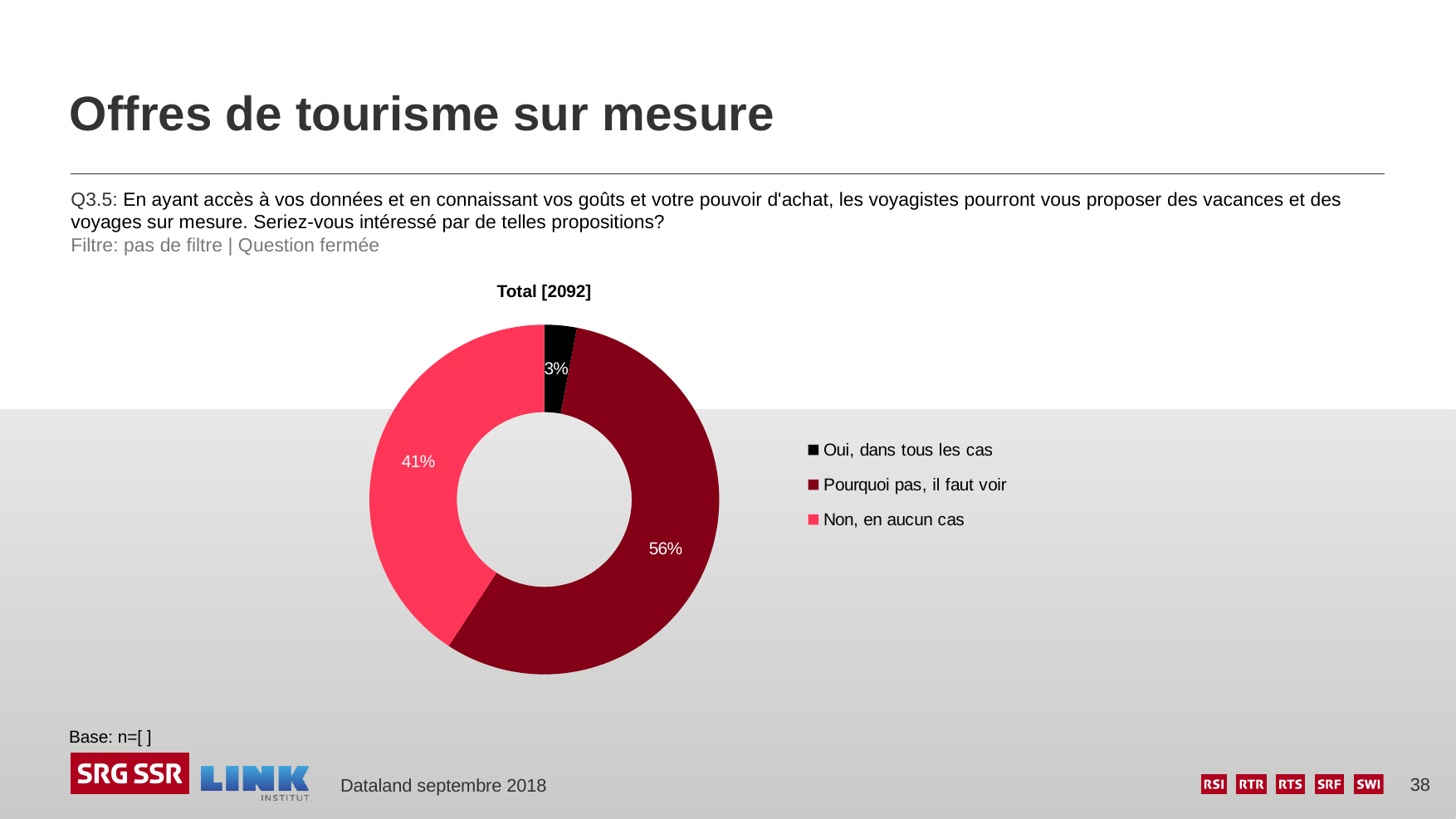
What share of respondents answered "Pourquoi pas, il faut voir"? 56% Which is larger: the share for "Non, en aucun cas" or the share for "Oui, dans tous les cas"? Non, en aucun cas Which colour represents "Oui, dans tous les cas" in the chart? Black What kind of chart is shown on the slide? Pie chart (doughnut) How many entries does the legend list? 3 What share of respondents answered "Non, en aucun cas"? 41% What is the title shown above the pie chart? Total [2092] Which response has the largest share of the pie? Pourquoi pas, il faut voir What share of respondents answered "Oui, dans tous les cas"? 3% How many categories does the pie chart show? 3 What is the difference in percentage points between "Pourquoi pas, il faut voir" and "Non, en aucun cas"? 15 percentage points Which response has the smallest share of the pie? Oui, dans tous les cas